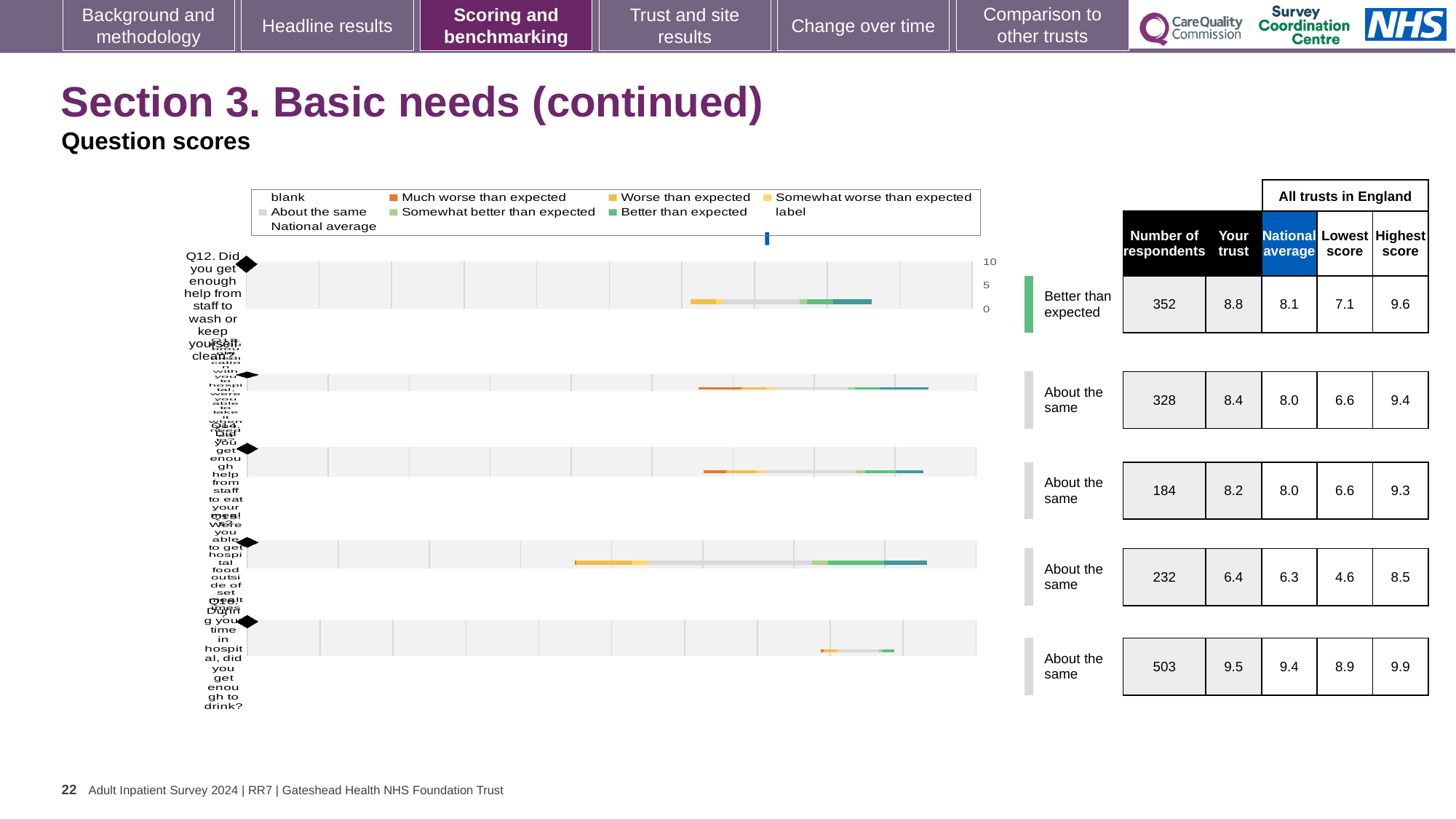
What is the 'Your trust' score for Q12 (the first row)? 8.8 What benchmark category is shown for Q12 (the first row)? Better than expected How many of the five rows are rated 'About the same'? 4 What is the highest score across all trusts in England for Q12 (the first row)? 9.6 What is the national average score for Q12 (the first row)? 8.1 Which row has the highest 'Your trust' score? the fifth (bottom) row, 9.5 For Q12 (the first row), which is larger: the 'Your trust' score or the national average? Your trust Which row has the lowest 'Your trust' score? the fourth row, 6.4 What kind of chart is used to show the question scores on this slide? bar chart What is the number of respondents for Q12 (the first row)? 352 How many question rows are plotted in the chart? 5 What is the difference between the 'Your trust' score and the national average for Q12 (the first row)? 0.7